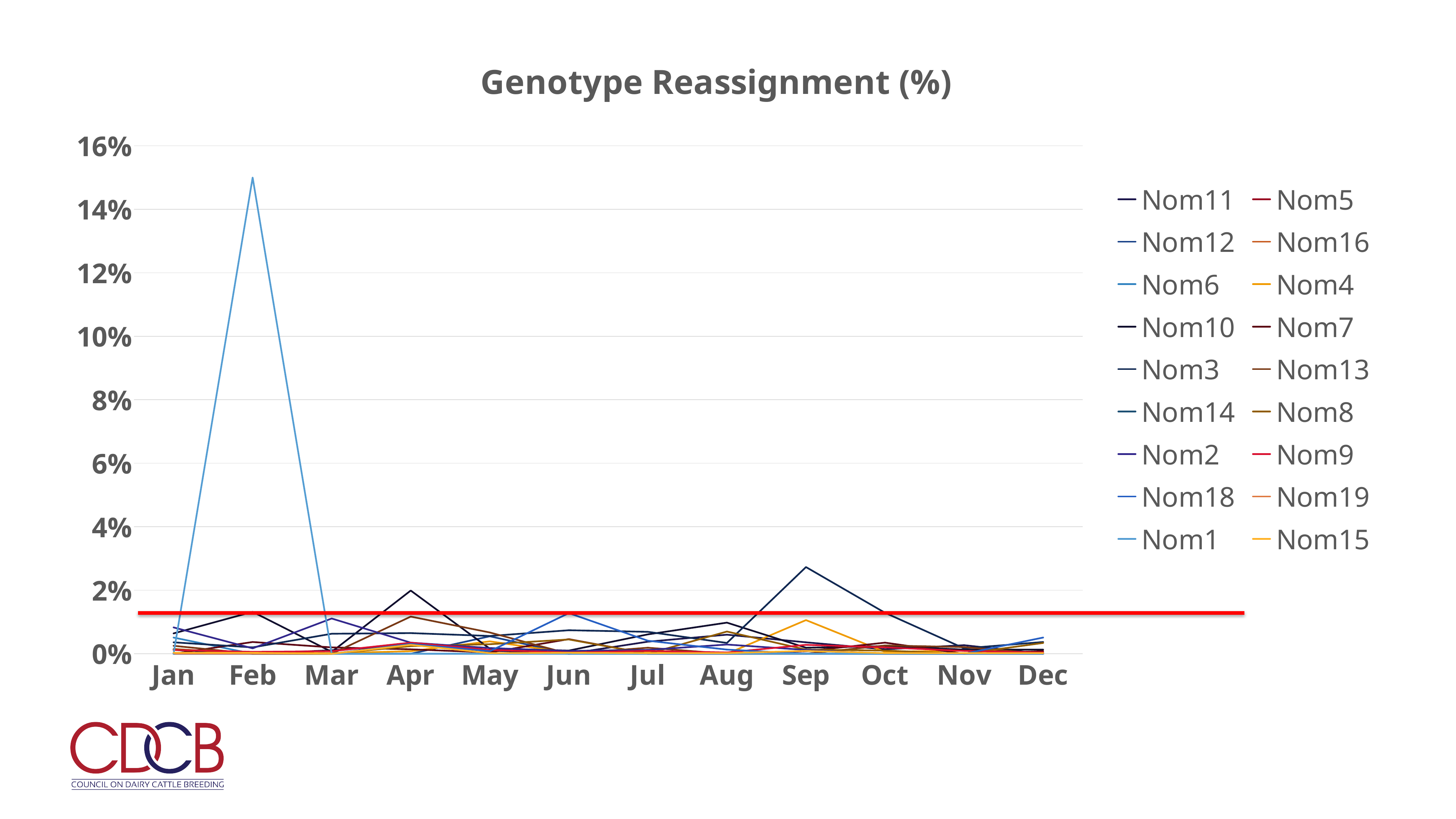
What is the highest value labelled on the y axis? 16% Does the tallest line rise or fall from Feb to Mar? fall How many series does the legend list? 18 Is the highest value plotted in Apr greater or less than 4%? less Is the highest value plotted in Sep greater or less than 4%? less In which month does the tallest spike in the chart occur? Feb What kind of chart is shown on the slide? line chart How many months are shown along the x axis of the chart? 12 Which month has a higher peak value, Feb or Sep? Feb What is the title of the chart? Genotype Reassignment (%) Is the highest value plotted in Feb greater or less than 10%? greater